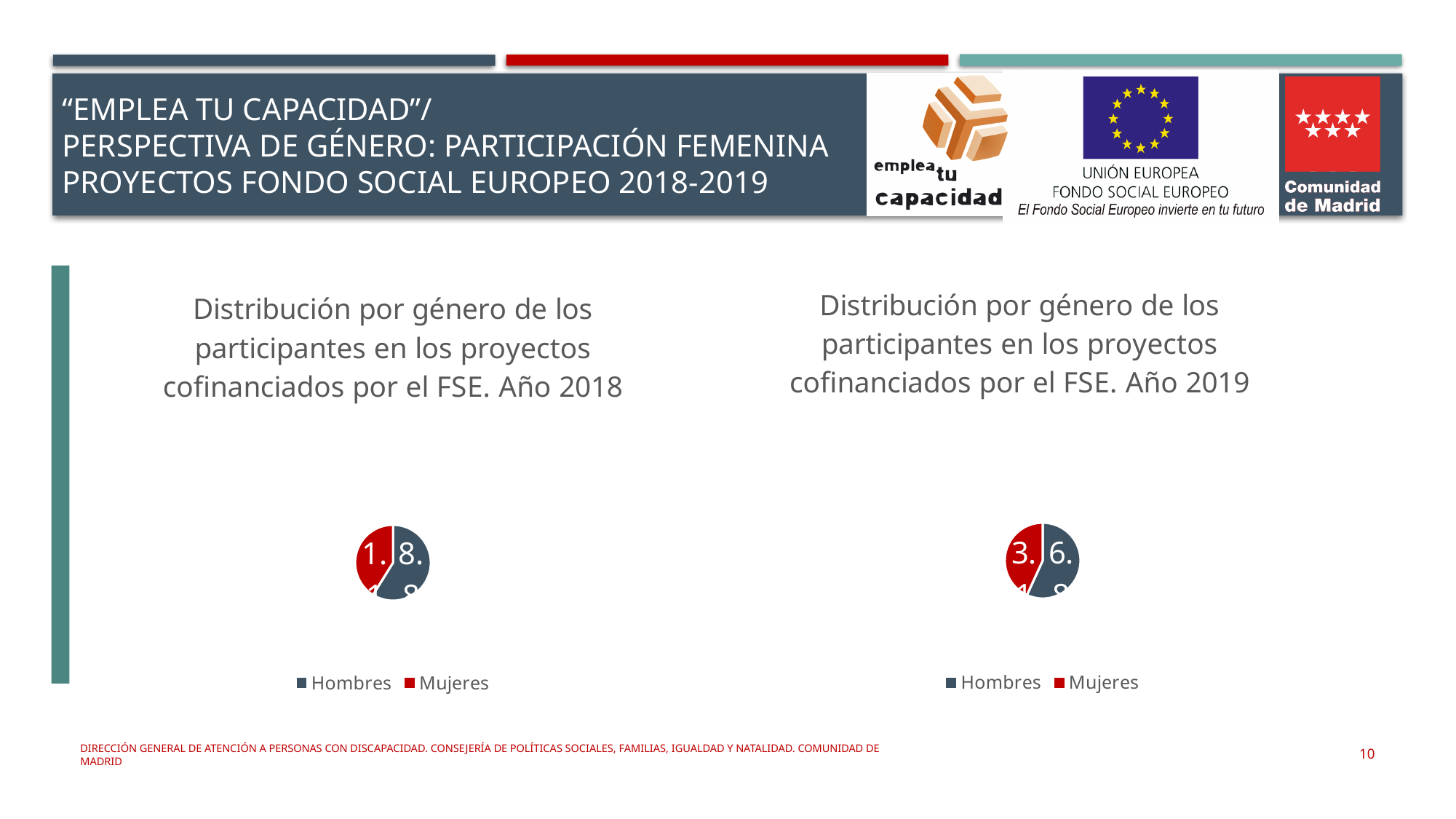
In the 2018 chart (left), how many slices does the pie have? 2 In the 2019 chart (right), which category has the smallest slice? Mujeres In the 2019 chart (right), how many categories does the legend list? 2 In the 2019 chart (right), which slice is larger, Hombres or Mujeres? Hombres In the 2019 chart (right), how many slices does the pie have? 2 In the 2018 chart (left), which slice is larger, Hombres or Mujeres? Hombres In the 2018 chart (left), how many categories does the legend list? 2 In the 2018 chart (left), what colour represents Mujeres in the legend? Red What kind of chart is the chart titled "Distribución por género de los participantes en los proyectos cofinanciados por el FSE. Año 2018"? Pie chart What are the two legend entries of the 2019 chart (right)? Hombres and Mujeres In the 2018 chart (left), which category has the largest slice? Hombres What kind of chart is the chart titled "Distribución por género de los participantes en los proyectos cofinanciados por el FSE. Año 2019"? Pie chart